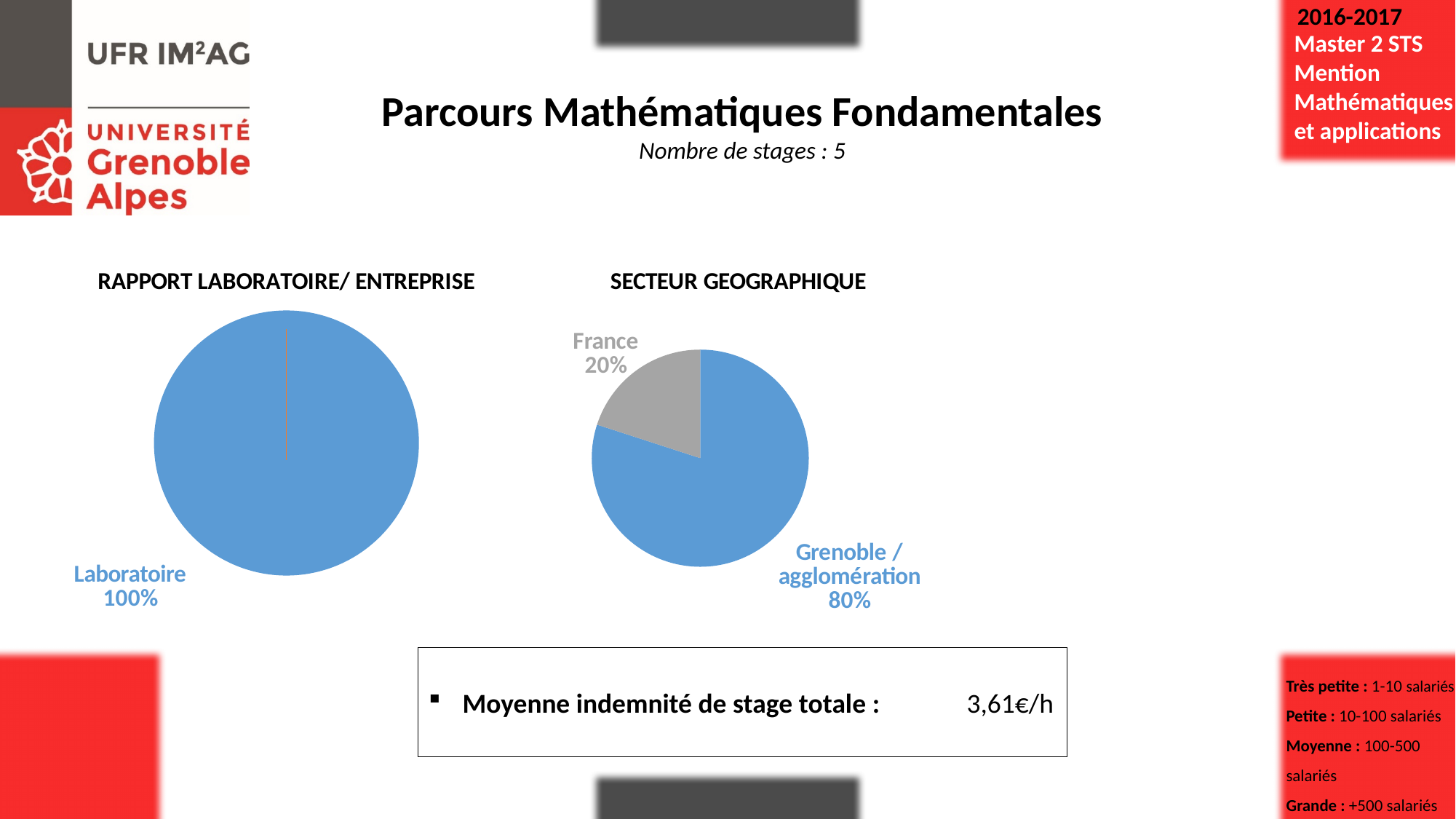
What kind of chart is the 'SECTEUR GEOGRAPHIQUE' chart? Pie chart In the 'SECTEUR GEOGRAPHIQUE' chart, which category has the smallest share? France What kind of chart is the 'RAPPORT LABORATOIRE/ ENTREPRISE' chart? Pie chart In the 'SECTEUR GEOGRAPHIQUE' chart, which category has the largest share? Grenoble / agglomération In the 'SECTEUR GEOGRAPHIQUE' chart, what is the difference in percentage points between 'Grenoble / agglomération' and 'France'? 60 percentage points In the 'SECTEUR GEOGRAPHIQUE' chart, what share does 'Grenoble / agglomération' have? 80% How many slices does the 'RAPPORT LABORATOIRE/ ENTREPRISE' chart have? 1 In the 'SECTEUR GEOGRAPHIQUE' chart, which is larger: 'France' or 'Grenoble / agglomération'? Grenoble / agglomération How many slices does the 'SECTEUR GEOGRAPHIQUE' chart have? 2 In the 'SECTEUR GEOGRAPHIQUE' chart, what colour is the 'France' slice? Grey In the 'RAPPORT LABORATOIRE/ ENTREPRISE' chart, what share does 'Laboratoire' have? 100% In the 'SECTEUR GEOGRAPHIQUE' chart, what share does 'France' have? 20%